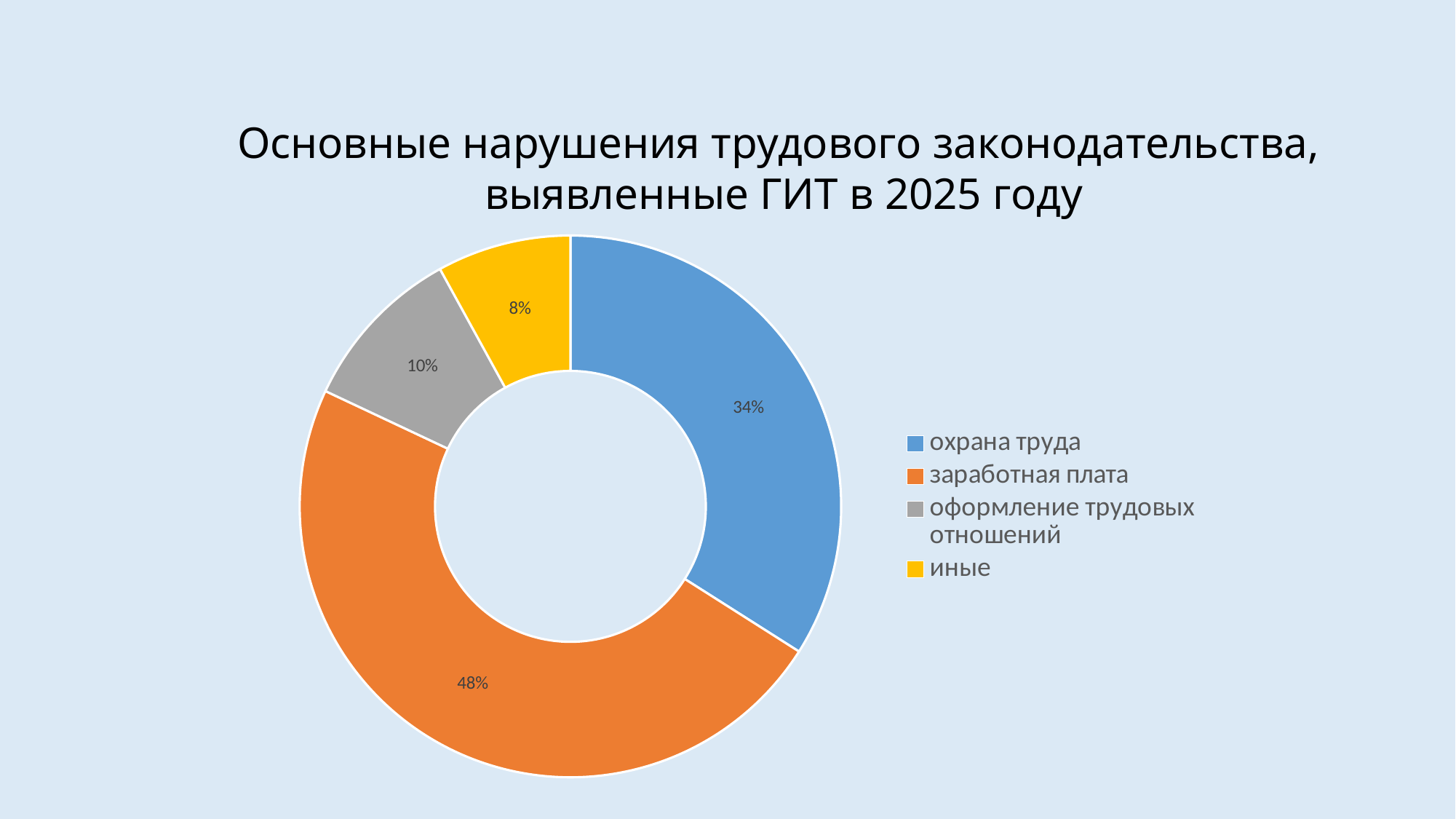
What is the difference in percentage points between "заработная плата" and "охрана труда"? 14 What share of the chart does "оформление трудовых отношений" account for? 10% What kind of chart is shown on the slide? Pie chart (doughnut) Which category has the largest share? заработная плата What is the title of the chart? Основные нарушения трудового законодательства, выявленные ГИТ в 2025 году What share of the chart does "иные" account for? 8% How many categories are shown in the chart? 4 What share of the chart does "заработная плата" account for? 48% Which category has the smallest share? иные Which colour represents "охрана труда" in the chart? Blue What share of the chart does "охрана труда" account for? 34% Which is larger, the share for "оформление трудовых отношений" or the share for "иные"? оформление трудовых отношений